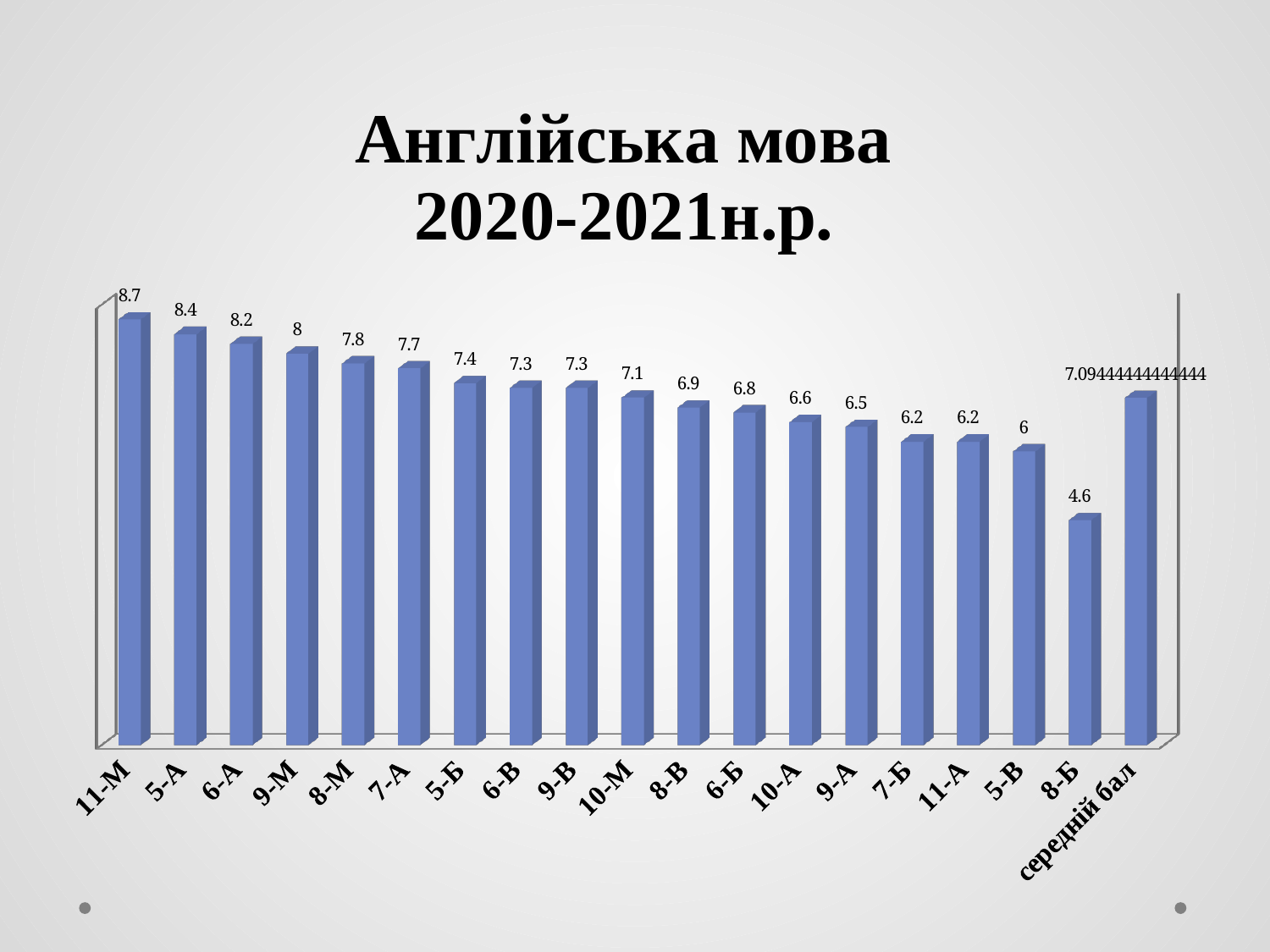
What is the title of the chart on the slide? Англійська мова 2020-2021н.р. What is the value for 11-М? 8.7 Which category has the lowest value? 8-Б What is the value shown for середній бал? 7.09444444444444 What is the value for 9-М? 8 What type of chart is shown on the slide? bar chart What is the difference between the values for 11-М and 8-Б? 4.1 Which category has the highest value? 11-М Which is larger, the value for 6-А or the value for 10-А? 6-А What is the value for 8-Б? 4.6 How many bars are plotted on the chart? 19 What is the difference between the values for 5-А and 5-В? 2.4